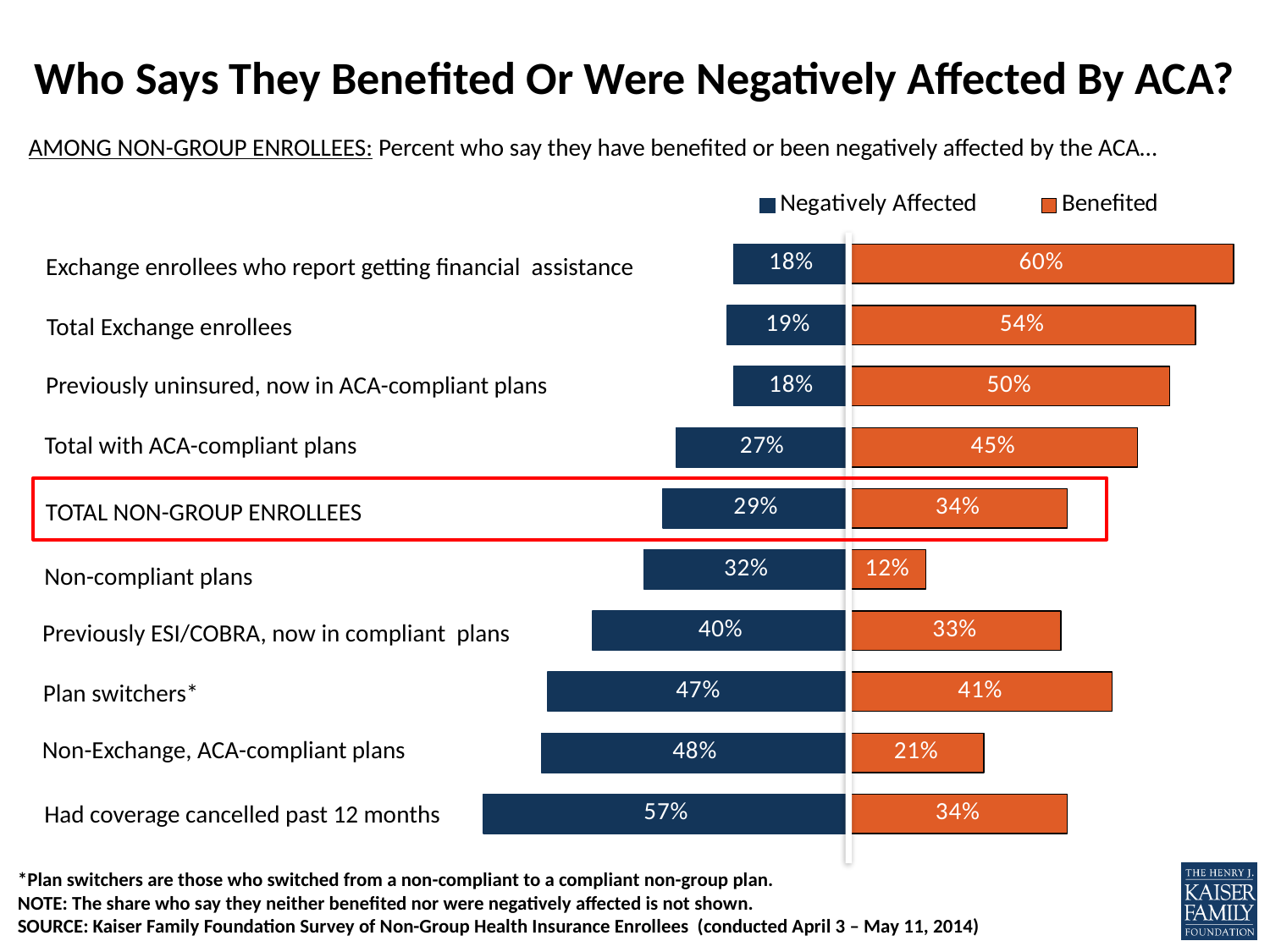
Which category has the lowest Benefited percentage? Non-compliant plans What percent of Total Exchange enrollees say they benefited from the ACA? 54% What kind of chart is shown on the slide? Bar chart For Non-Exchange, ACA-compliant plans, which is larger: the Negatively Affected share or the Benefited share? Negatively Affected What percent of those who had coverage cancelled in the past 12 months say they were negatively affected by the ACA? 57% Which category has the highest Benefited percentage? Exchange enrollees who report getting financial assistance What is the difference between the Benefited and Negatively Affected percentages for Plan switchers*? 6 percentage points Which category is highlighted with a red box on the chart? TOTAL NON-GROUP ENROLLEES How many series does the legend list? 2 How many categories are shown in the chart? 10 What is the Benefited value for TOTAL NON-GROUP ENROLLEES? 34% Which category has the highest Negatively Affected percentage? Had coverage cancelled past 12 months